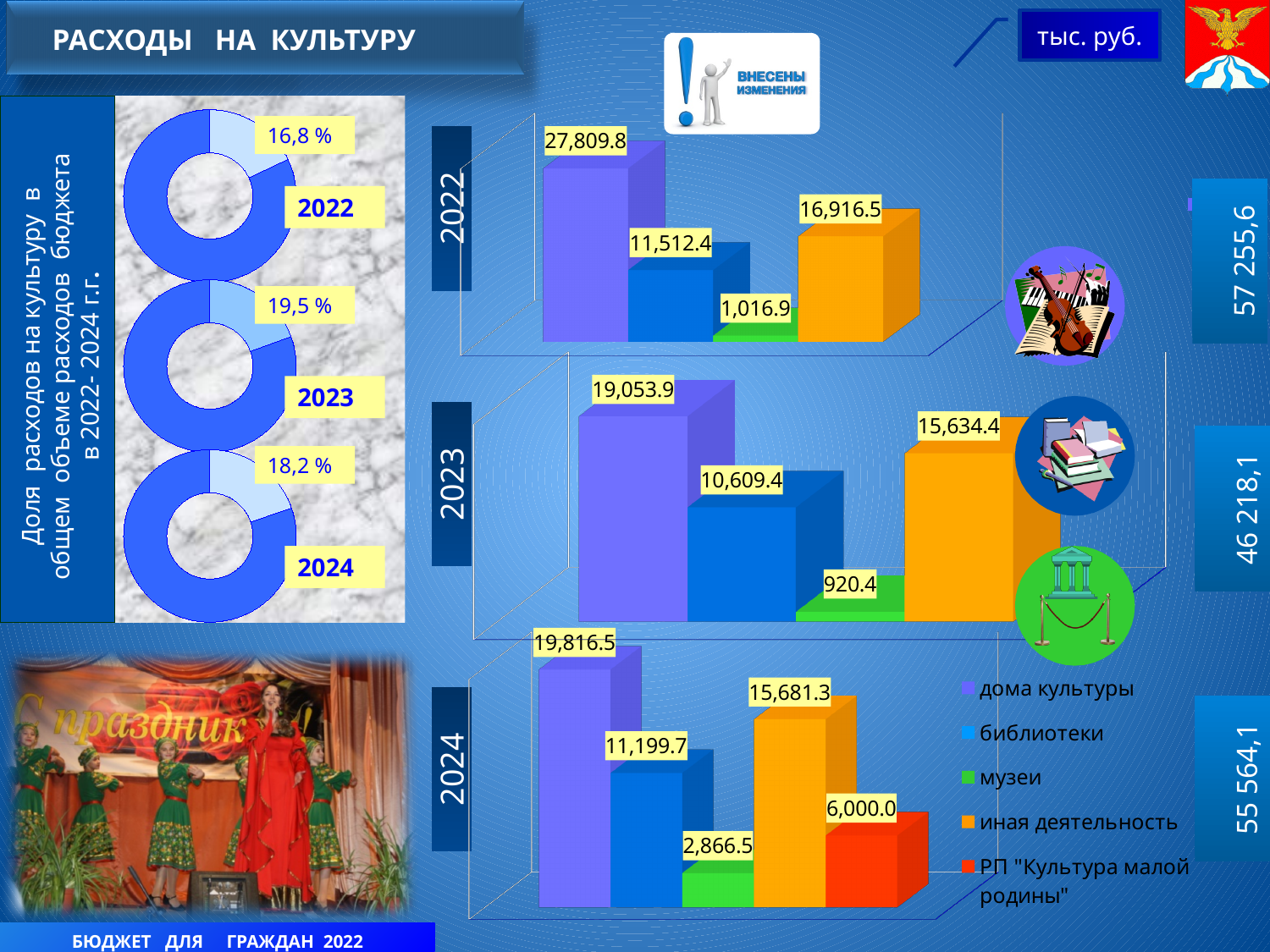
What type of chart is used to show the 2022, 2023 and 2024 expenditure breakdowns on the right side of the slide? bar chart In the 2022 bar chart, what is the difference between библиотеки and музеи? 10,495.5 In the 2023 bar chart, which is larger: библиотеки or иная деятельность? иная деятельность In the 2022 bar chart, which category has the lowest value? музеи In the donut chart for 2023 on the left, what share of total budget expenditure goes to culture? 19,5 % In the 2024 bar chart, what is the difference between дома культуры and иная деятельность? 4,135.2 How many series does the legend of the bar charts list? 5 In the 2024 bar chart, what is the value for РП "Культура малой родины"? 6,000.0 In the 2022 bar chart, what is the value for дома культуры? 27,809.8 How many bars are shown in the 2024 bar chart? 5 In the 2023 bar chart, what is the value for библиотеки? 10,609.4 In the 2023 bar chart, which category has the highest value? дома культуры